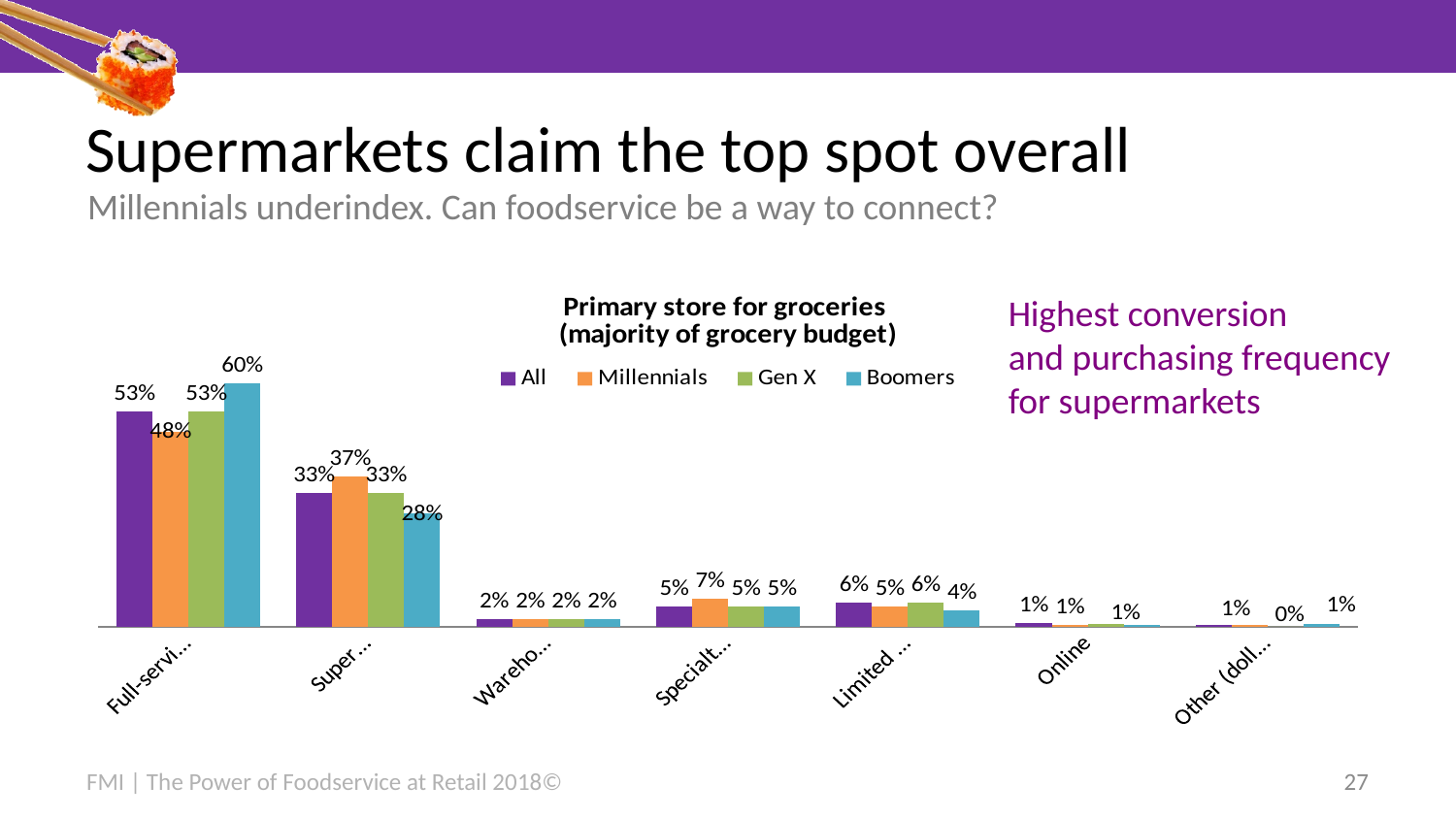
What is the title of the chart? Primary store for groceries (majority of grocery budget) In the first category on the left (Full-servi...), which series has the highest value? Boomers What is the value for Gen X in the last category on the right (Other (doll...)? 0% How many series does the legend of the chart list? 4 What is the value for Millennials in the Online category? 1% In the first category on the left (Full-servi...), what is the difference between the Boomers value and the Millennials value? 12 percentage points Do the values generally rise or fall moving from left to right along the x axis? fall What is the value for Boomers in the Online category? 1% How many store categories are shown along the x axis of the chart? 7 In the second category (Super...), which is larger: the Millennials value or the Boomers value? Millennials In the last category on the right (Other (doll...), which series has the lowest value? Gen X What type of chart is shown on the slide? bar chart